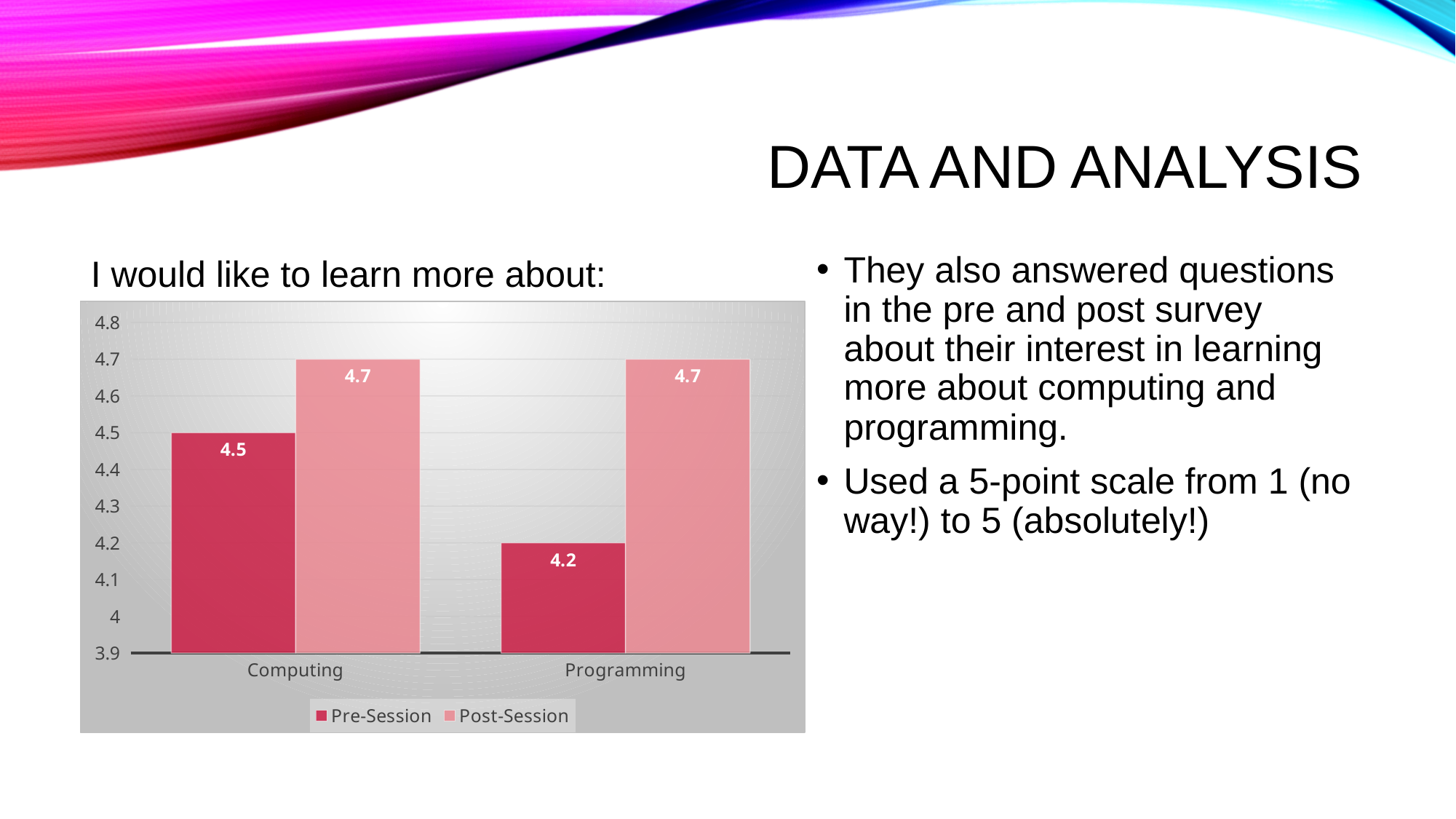
Is the Pre-Session value for Programming greater or less than 4.4? less Which category has the lowest Pre-Session value? Programming How many categories are shown on the x axis? 2 What is the difference between the Post-Session and Pre-Session values for Computing? 0.2 What kind of chart is shown on the slide? bar chart What is the difference between the Post-Session and Pre-Session values for Programming? 0.5 What is the Post-Session value for Computing? 4.7 Which is larger, the Pre-Session value for Computing or the Pre-Session value for Programming? Pre-Session value for Computing How many series does the legend list? 2 What is the Pre-Session value for Computing? 4.5 What is the Pre-Session value for Programming? 4.2 What is the Post-Session value for Programming? 4.7